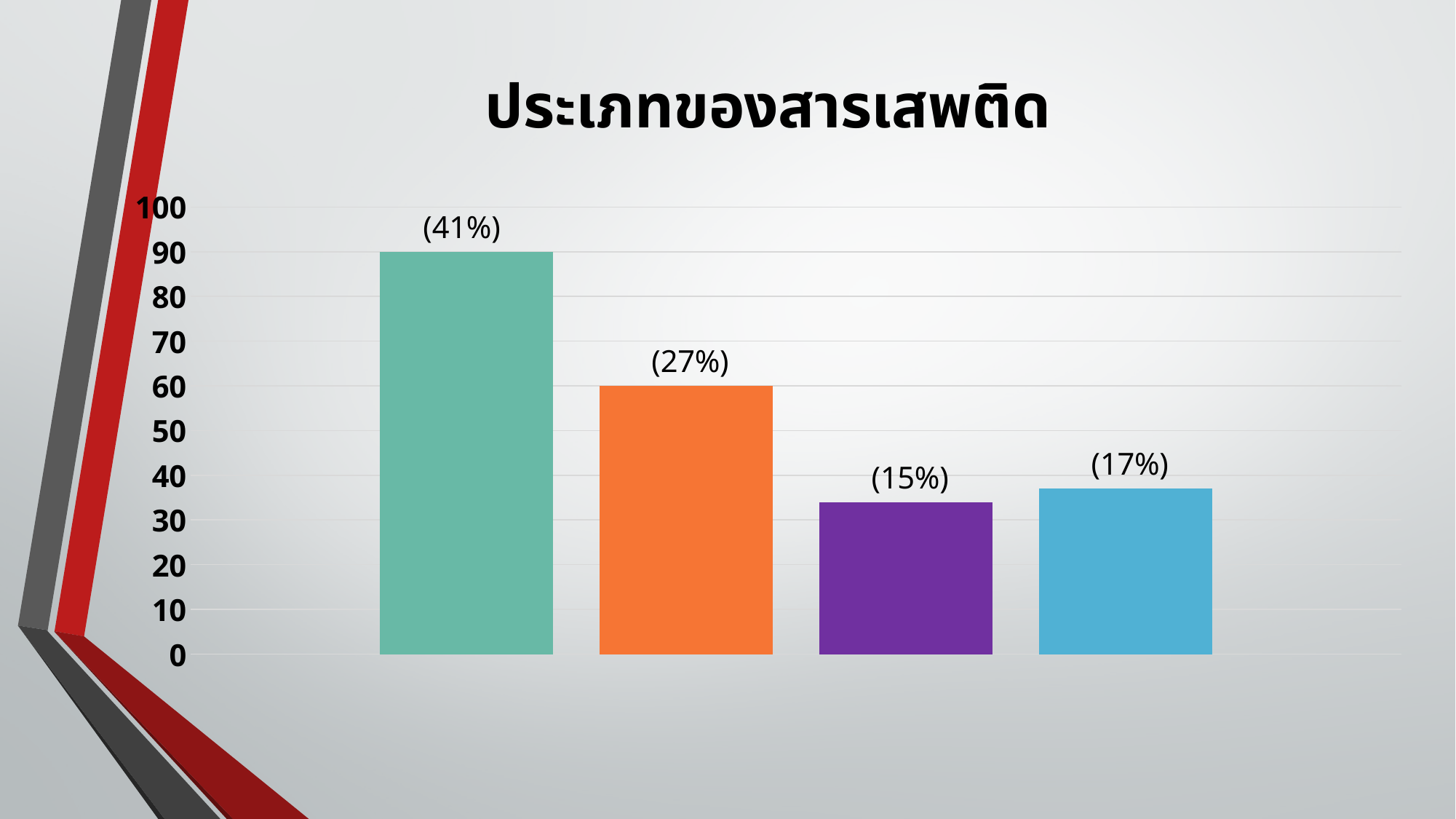
What data label is printed above the fourth (blue) bar? (17%) Which is taller, the orange bar or the blue bar? the orange bar What is the title of the chart? ประเภทของสารเสพติด What data label is printed above the third (purple) bar? (15%) What data label is printed above the first (teal) bar? (41%) What data label is printed above the second (orange) bar? (27%) How many bars are plotted in the chart? 4 What kind of chart is shown on the slide? bar chart Is the value for the first (teal) bar greater or less than 80? greater Which bar is the tallest in the chart? the first (teal) bar Is the value for the third (purple) bar greater or less than 40? less Which bar is the shortest in the chart? the third (purple) bar